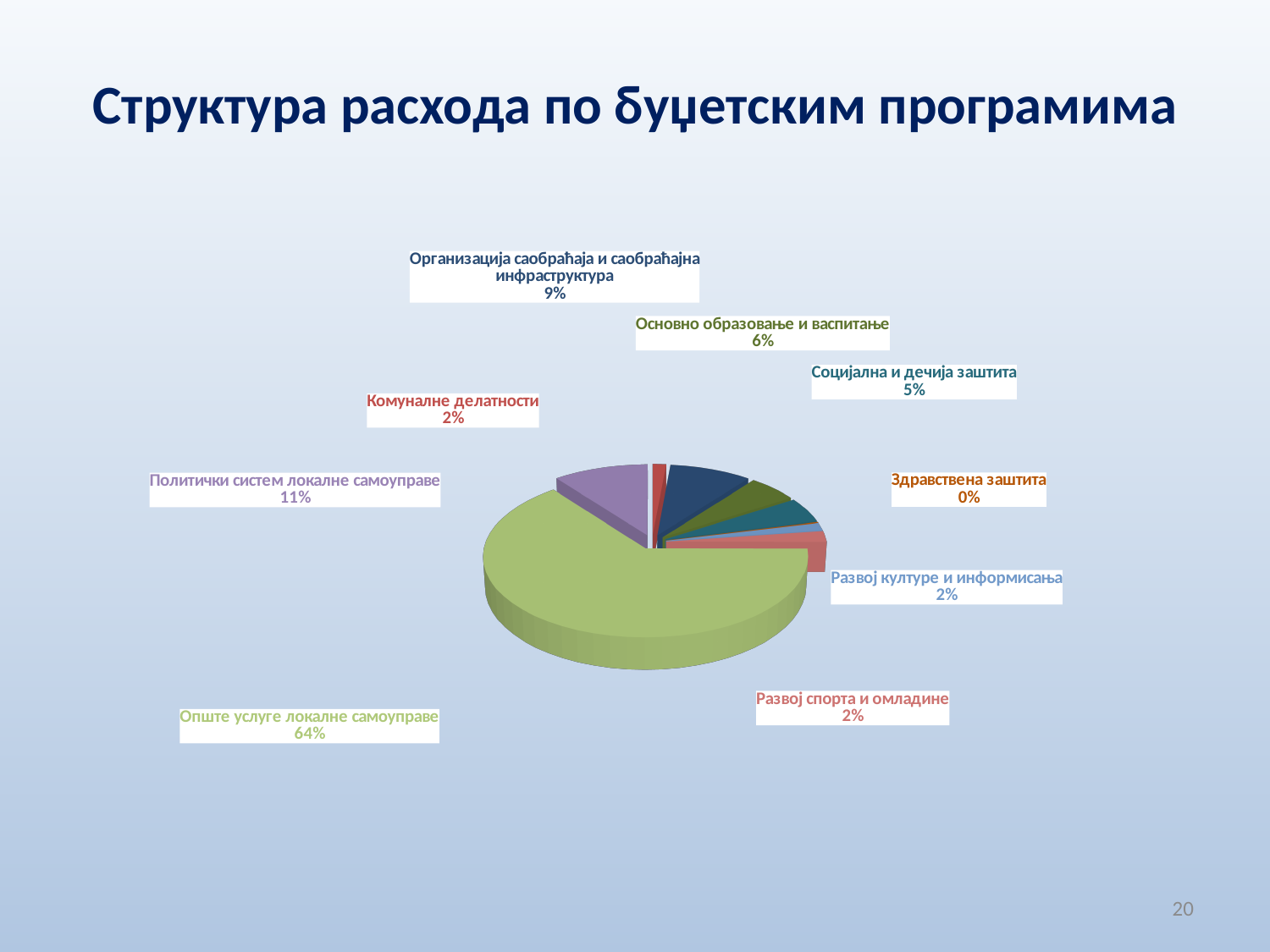
What kind of chart is shown on the slide? Pie chart What share is shown for Здравствена заштита? 0% Which budget programme has the smallest share of expenditure? Здравствена заштита What share is shown for Организација саобраћаја и саобраћајна инфраструктура? 9% Which budget programme has the largest share of expenditure? Опште услуге локалне самоуправе What share of expenditure goes to Опште услуге локалне самоуправе? 64% What is the difference in percentage points between Политички систем локалне самоуправе and Основно образовање и васпитање? 5 How many budget programmes are shown in the pie chart? 9 Which has a larger share, Организација саобраћаја и саобраћајна инфраструктура or Социјална и дечија заштита? Организација саобраћаја и саобраћајна инфраструктура